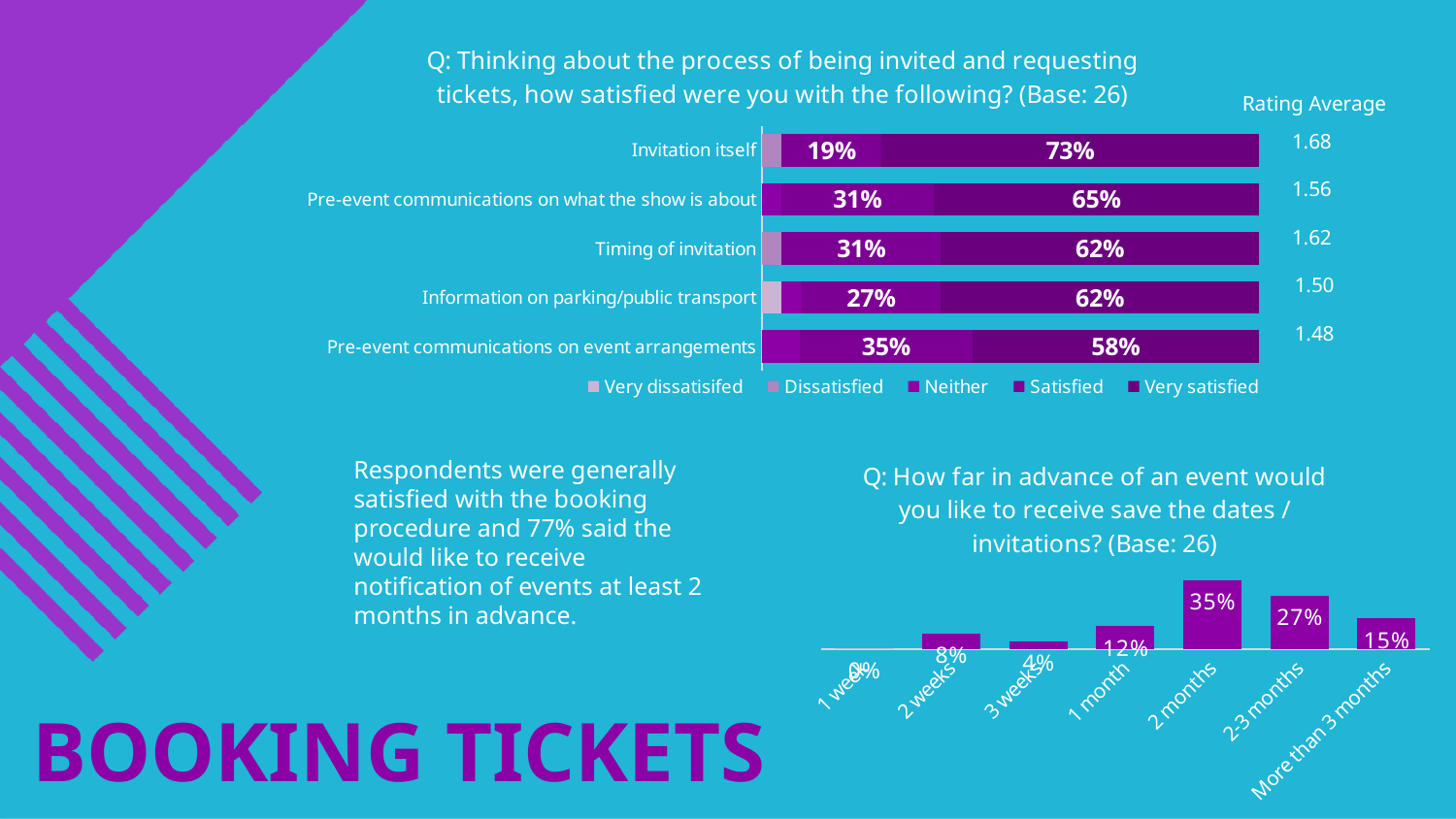
In the satisfaction chart at the top, which category has the highest very satisfied percentage? Invitation itself In the chart about how far in advance respondents would like to receive invitations, what percentage chose 2 months? 35% What kind of chart is the one about how far in advance respondents would like to receive invitations? Bar chart In the satisfaction chart at the top, what percentage were satisfied with pre-event communications on event arrangements? 35% In the satisfaction chart at the top, what percentage were very satisfied with the invitation itself? 73% In the satisfaction chart at the top, which category has the lowest very satisfied percentage? Pre-event communications on event arrangements In the satisfaction chart at the top, what is the rating average shown for information on parking/public transport? 1.50 In the chart about how far in advance respondents would like to receive invitations, which option has the lowest percentage? 1 week In the satisfaction chart at the top, how many series does the legend list? 5 In the satisfaction chart at the top, what is the difference between the very satisfied percentages for invitation itself and timing of invitation? 11% In the chart about how far in advance respondents would like to receive invitations, how many categories are shown? 7 In the chart about how far in advance respondents would like to receive invitations, which is larger: 2-3 months or more than 3 months? 2-3 months